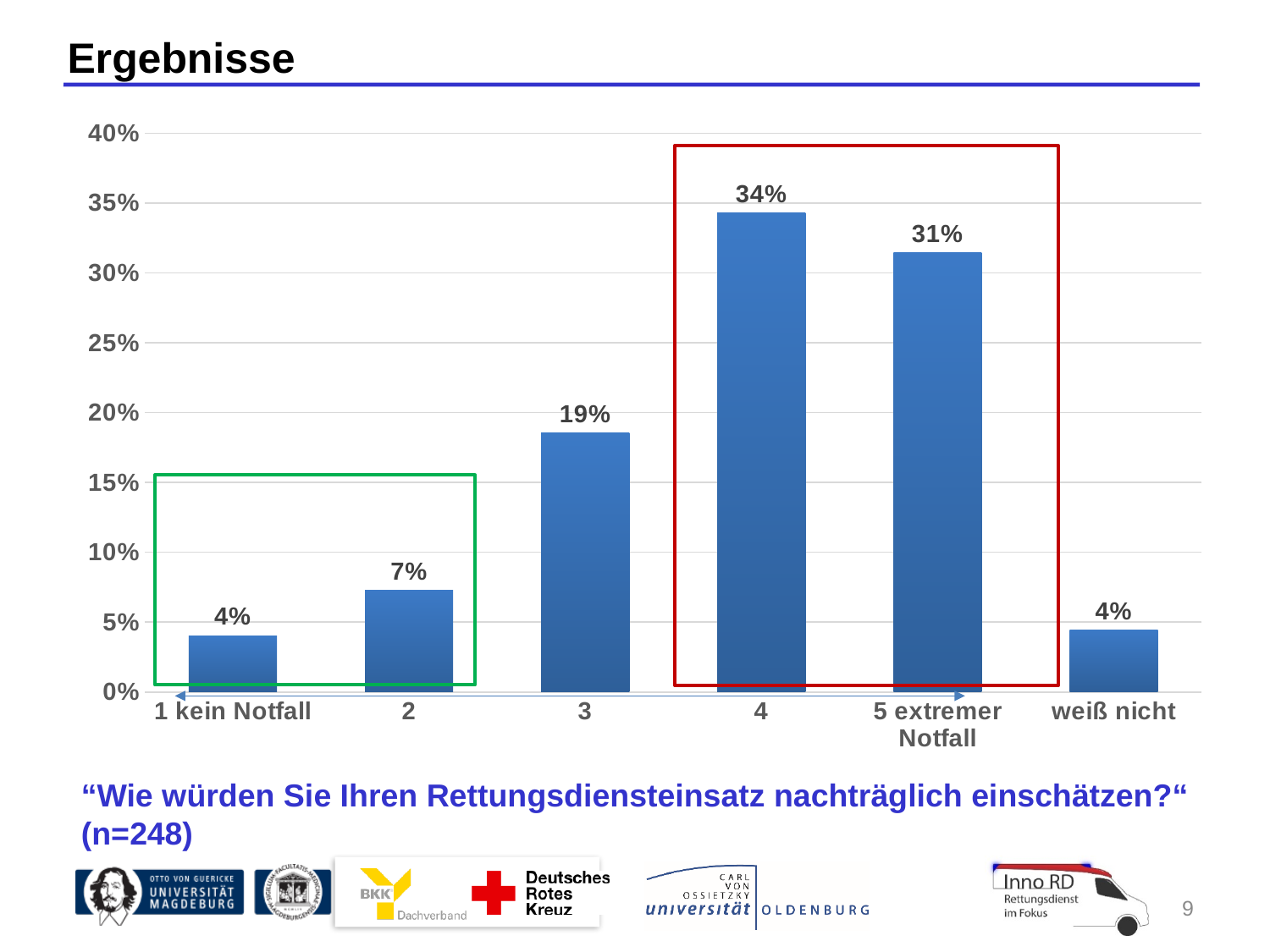
What is the value for the category "4"? 34% What kind of chart is shown on the slide? bar chart Which category has the highest value? 4 What is the value for the category "3"? 19% What is the value for "5 extremer Notfall"? 31% What is the sample size (n) stated below the chart? 248 What is the value for "1 kein Notfall"? 4% What is the highest value shown on the y axis? 40% What is the difference between the values for "4" and "5 extremer Notfall"? 3% What is the difference between the values for "3" and "2"? 12% How many categories are shown on the x axis? 6 Which is larger, the value for "2" or the value for "weiß nicht"? 2